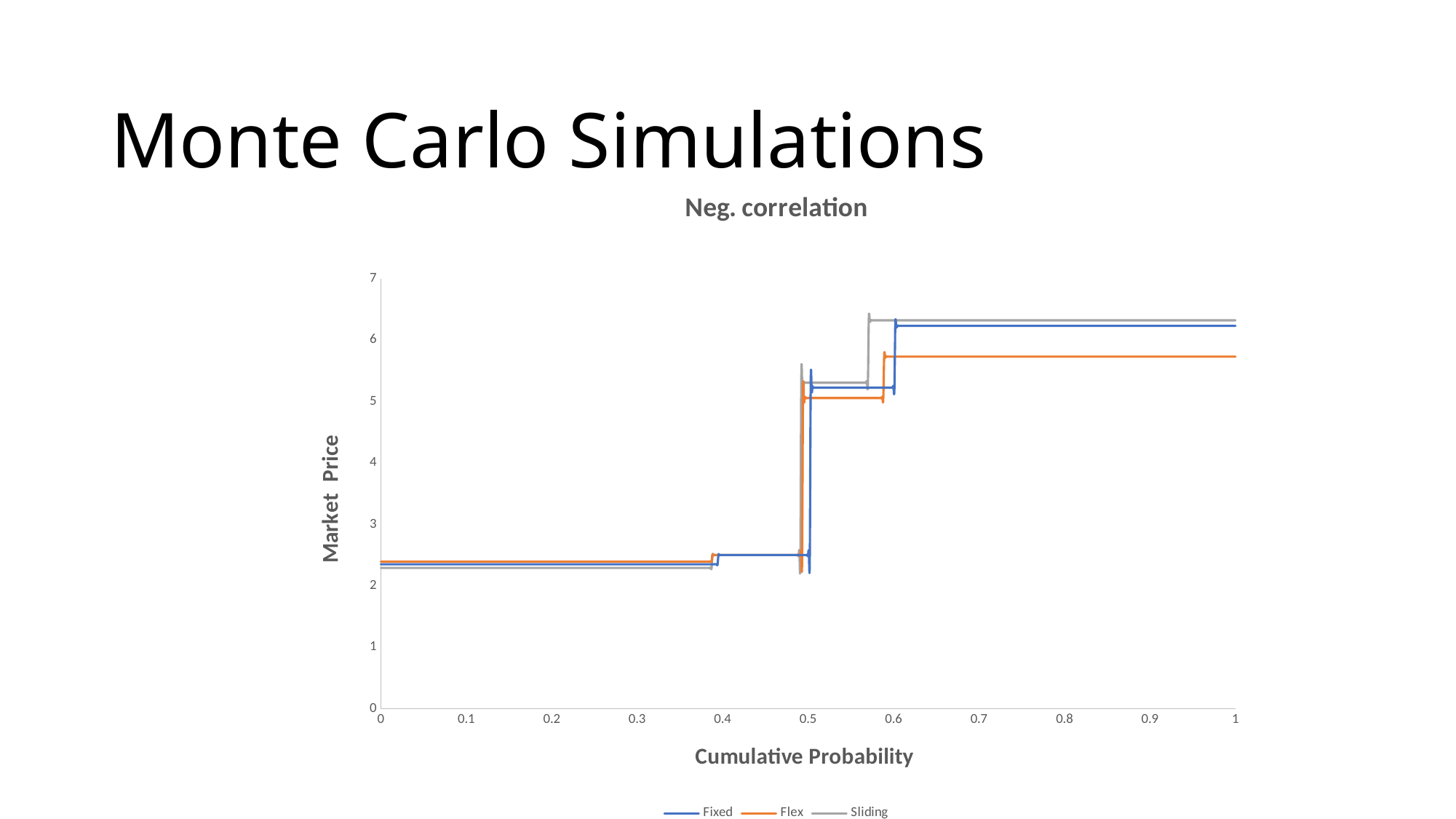
What is the label of the vertical axis? Market Price Is the value of the Flex series at a cumulative probability of 0.8 greater or less than 5? greater What kind of chart is shown on the slide? line chart Is the value of the Sliding series at a cumulative probability of 0.55 greater or less than 4? greater Is the value of the Fixed series at a cumulative probability of 0.7 greater or less than 6? greater How many series does the legend list? 3 Do the values of the Fixed series rise or fall as cumulative probability increases? rise At a cumulative probability of 0.8, which series has the higher value, Sliding or Flex? Sliding What is the title of the chart? Neg. correlation Which series has the lowest value at a cumulative probability of 0.9? Flex